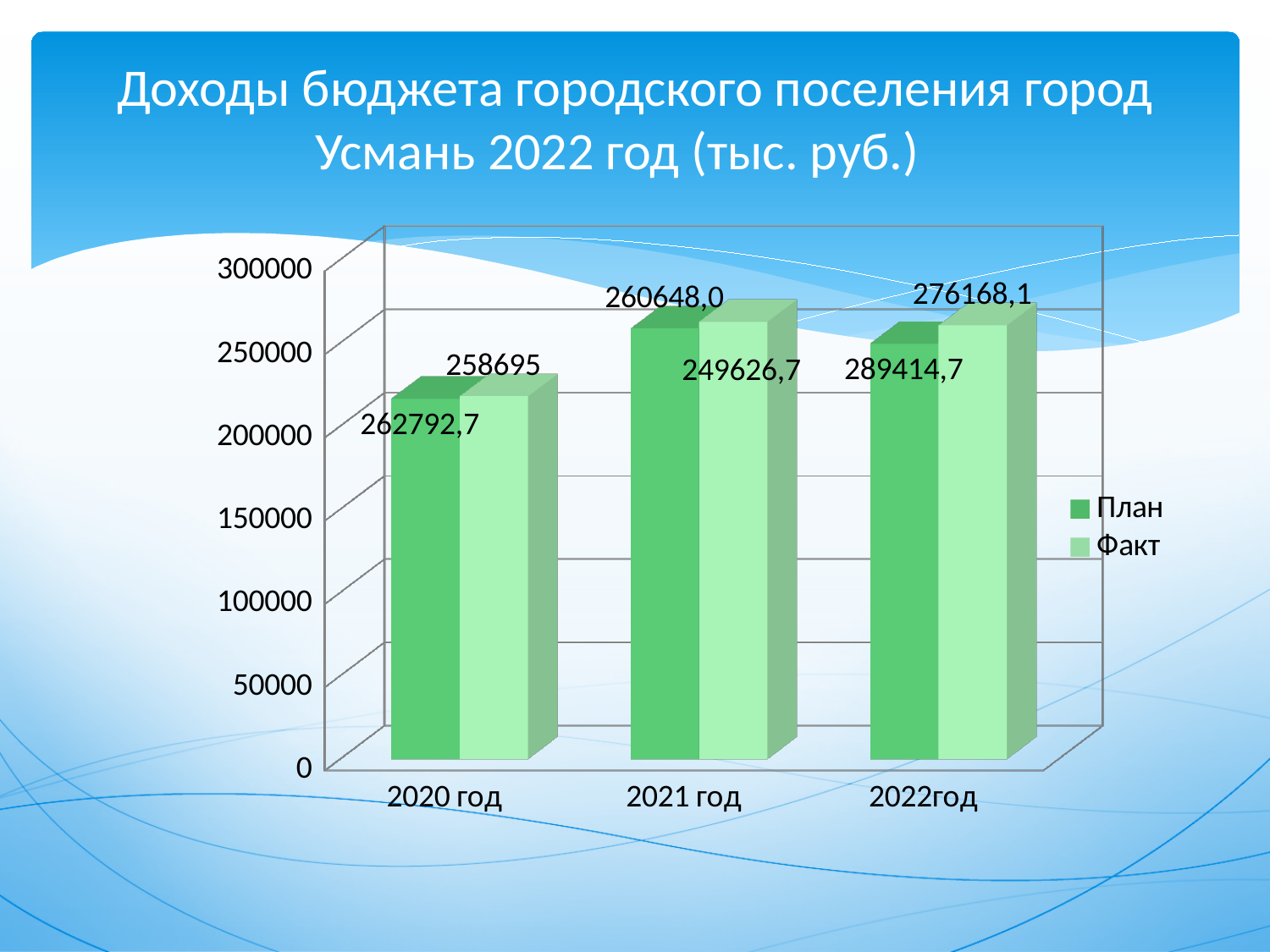
What is the Факт value for 2020 год? 258695 What is the План value for 2021 год? 260648,0 What is the План value for 2022год? 289414,7 What kind of chart is shown on the slide? bar chart What is the difference between the План and Факт values for 2021 год? 11021,3 What is the Факт value for 2021 год? 249626,7 What is the План value for 2020 год? 262792,7 What is the Факт value for 2022год? 276168,1 What is the difference between the План and Факт values for 2022год? 13246,6 Is the Факт value for 2021 год greater or less than 200000? greater How many series does the legend list? 2